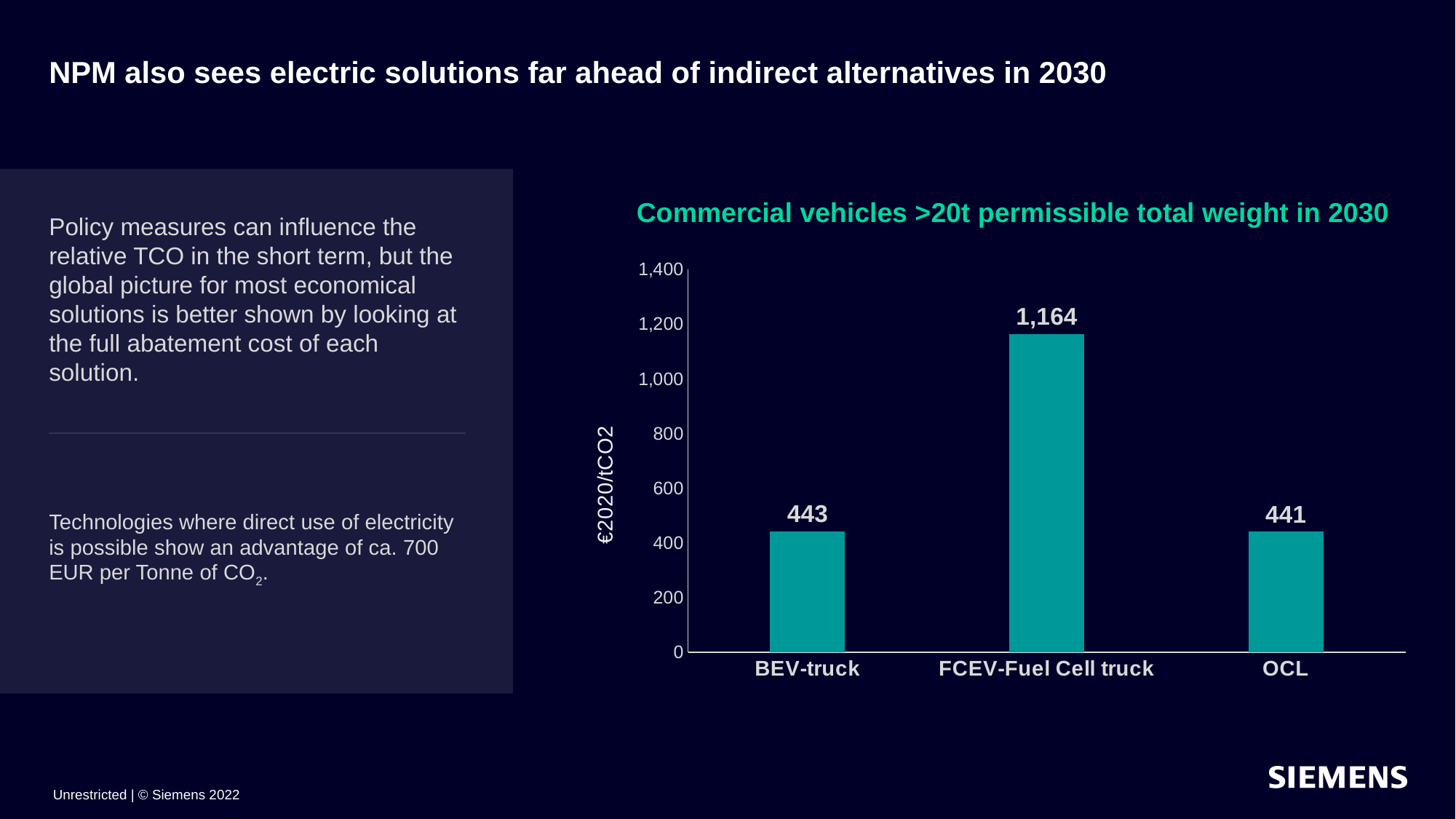
What is the value for FCEV-Fuel Cell truck? 1,164 What is the value for OCL? 441 Is the value for OCL greater or less than 600? less What is the difference between the values for FCEV-Fuel Cell truck and BEV-truck? 721 What kind of chart is shown? bar chart What is the value for BEV-truck? 443 How many categories are shown on the x axis? 3 Which category has the highest value? FCEV-Fuel Cell truck What is the title of the chart? Commercial vehicles >20t permissible total weight in 2030 Which is larger, the value for FCEV-Fuel Cell truck or the value for OCL? FCEV-Fuel Cell truck What is the difference between the values for BEV-truck and OCL? 2 Is the value for FCEV-Fuel Cell truck greater or less than 1,000? greater